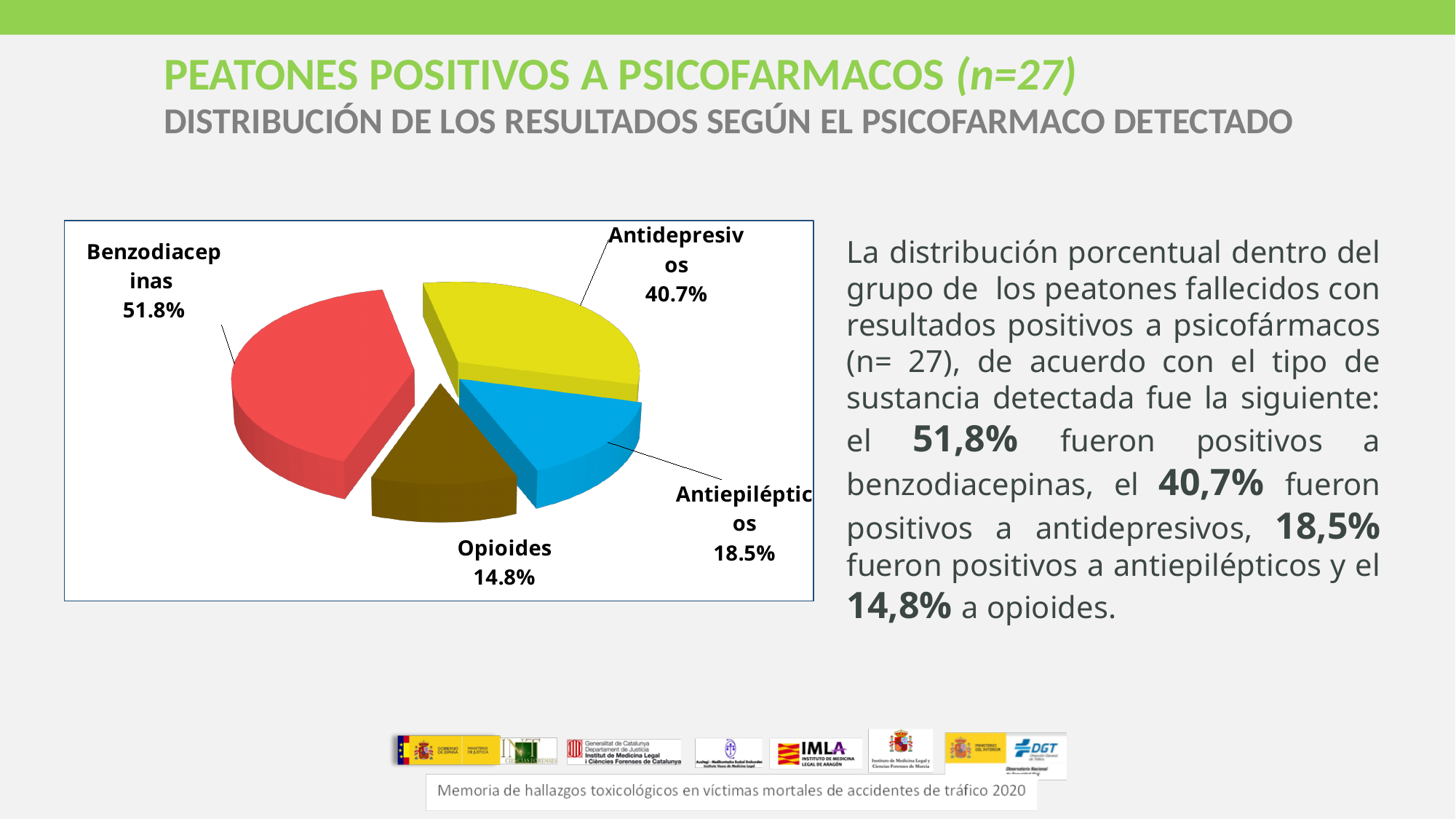
What kind of chart is shown on the slide? Pie chart Which is larger, the share for Antiepilépticos or the share for Opioides? Antiepilépticos What colour is the Benzodiacepinas slice? Red What percentage is shown for Opioides? 14.8% Which category has the largest slice of the pie? Benzodiacepinas What percentage is shown for Antidepresivos? 40.7% What percentage is shown for Benzodiacepinas? 51.8% How many categories are shown in the pie chart? 4 What is the difference in percentage points between Benzodiacepinas and Antidepresivos? 11.1 Which category has the smallest slice of the pie? Opioides What percentage is shown for Antiepilépticos? 18.5% What is the difference in percentage points between Antiepilépticos and Opioides? 3.7